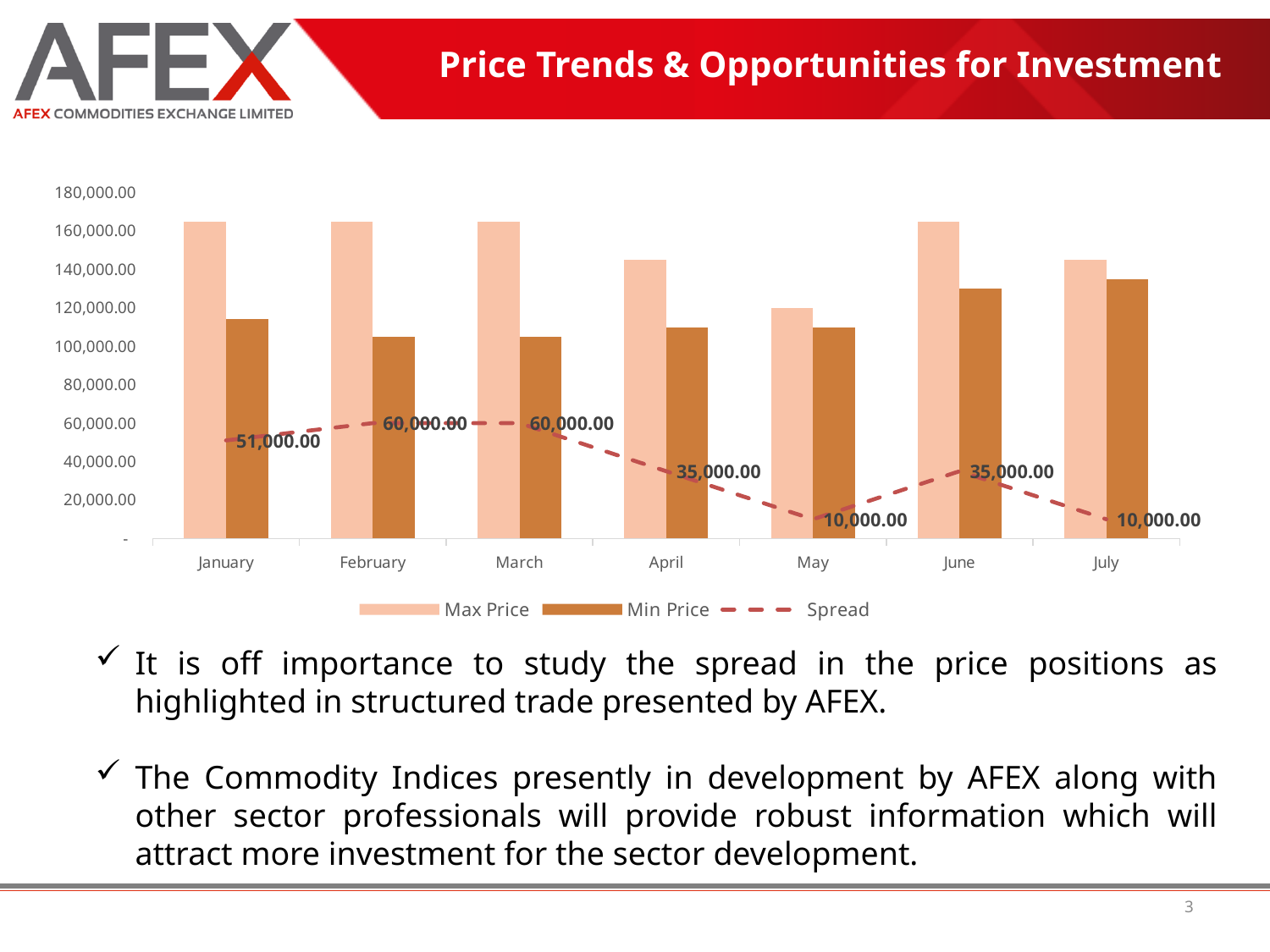
What is the Spread value for April? 35,000.00 Which is larger, the Min Price for June or the Min Price for February? June Which month has the lowest Max Price? May What is the Spread value for May? 10,000.00 How many months are shown on the x axis? 7 Does the Spread rise or fall from March to May? fall How many series does the legend list? 3 What is the Spread value for January? 51,000.00 Is the Min Price for July greater or less than 120,000.00? greater What is the Spread value for February? 60,000.00 Is the Max Price for May greater or less than 140,000.00? less What is the difference between the Spread in March and the Spread in April? 25,000.00